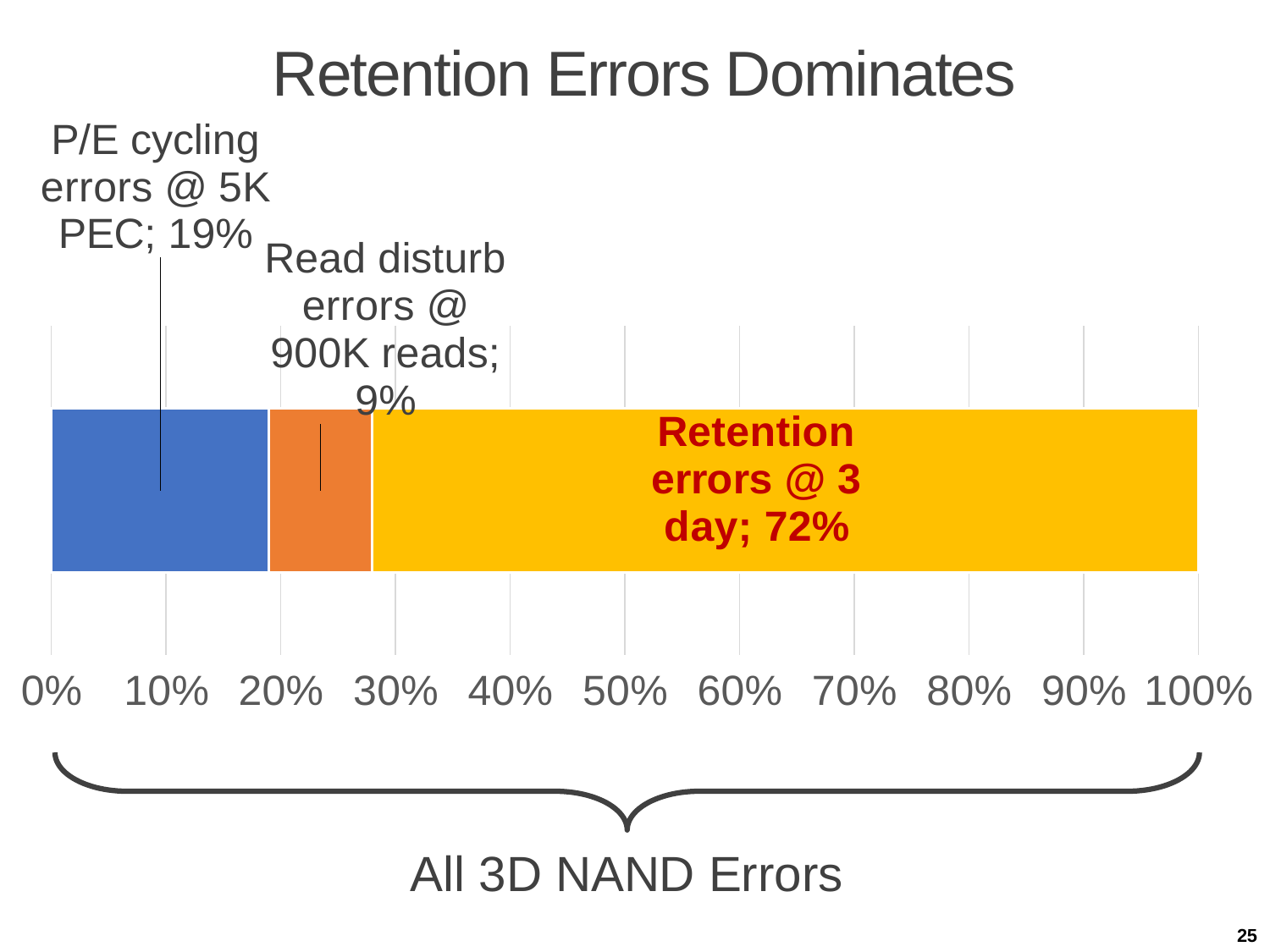
Which is larger: the share of P/E cycling errors or the share of read disturb errors? P/E cycling errors What share of all 3D NAND errors is attributed to retention errors @ 3 day? 72% What kind of chart is shown on the slide? Stacked bar chart How many error categories are shown in the stacked bar? 3 Which error type accounts for the largest share of all 3D NAND errors? Retention errors @ 3 day What share of all 3D NAND errors is attributed to read disturb errors @ 900K reads? 9% What is the difference in percentage points between the P/E cycling errors share and the read disturb errors share? 10 Which error type accounts for the smallest share of all 3D NAND errors? Read disturb errors @ 900K reads What share of all 3D NAND errors is attributed to P/E cycling errors @ 5K PEC? 19% Is the share of retention errors greater or less than 50%? greater What is the title of the slide containing the chart? Retention Errors Dominates What is the difference in percentage points between the retention errors share and the P/E cycling errors share? 53